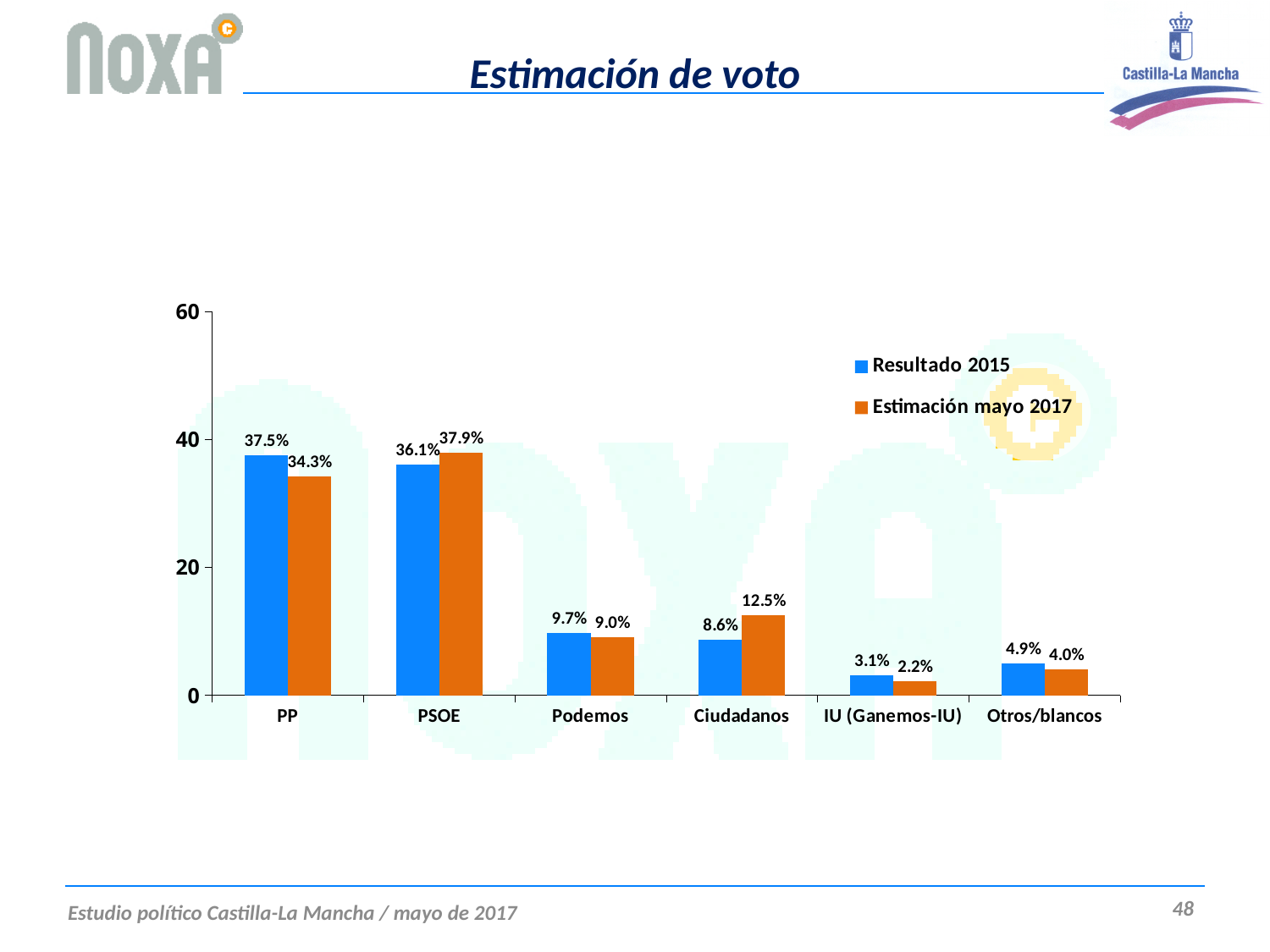
What is the Resultado 2015 value for IU (Ganemos-IU)? 3.1% Is the Estimación mayo 2017 value for PSOE greater or less than 20? greater What is the Estimación mayo 2017 value for PSOE? 37.9% Which is larger for Ciudadanos: the Resultado 2015 value or the Estimación mayo 2017 value? Estimación mayo 2017 What is the difference between the Resultado 2015 and Estimación mayo 2017 values for PP? 3.2% Which category has the highest Estimación mayo 2017 value? PSOE What is the Estimación mayo 2017 value for Ciudadanos? 12.5% What is the Resultado 2015 value for PP? 37.5% Which category has the lowest Resultado 2015 value? IU (Ganemos-IU) How many categories are shown on the x axis? 6 What kind of chart is shown on the slide? Bar chart How many series does the legend list? 2